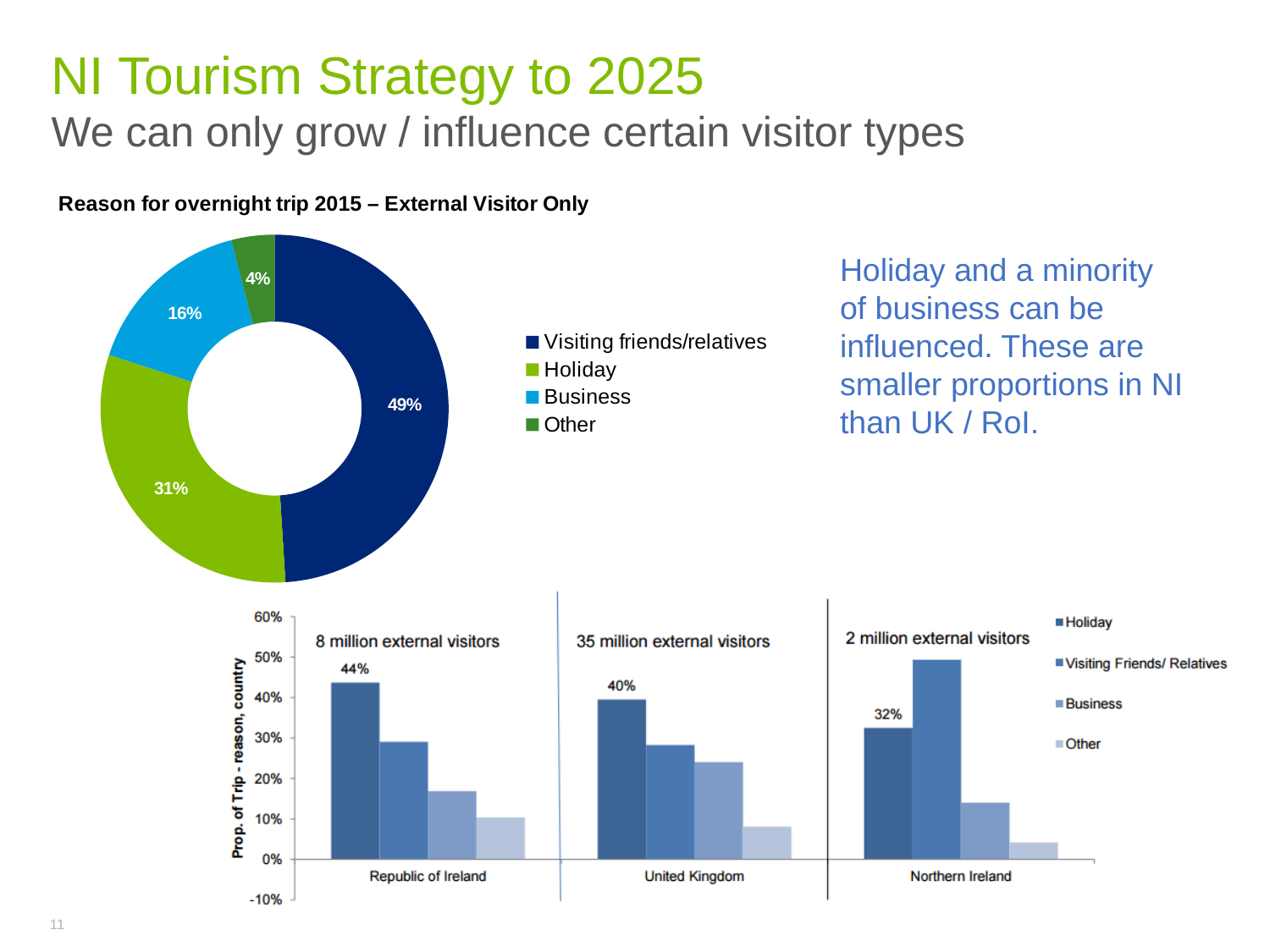
In the bar chart at the bottom of the slide, is the Visiting Friends/Relatives value for Northern Ireland greater or less than 40%? greater What type of chart is shown at the bottom of the slide? Bar chart How many categories does the legend of the donut chart 'Reason for overnight trip 2015 – External Visitor Only' list? 4 In the donut chart 'Reason for overnight trip 2015 – External Visitor Only', what is the difference in percentage points between Visiting friends/relatives and Holiday? 18 In the bar chart at the bottom of the slide, what is the Holiday value for Republic of Ireland? 44% In the bar chart at the bottom of the slide, which country has the lowest Holiday value? Northern Ireland In the bar chart at the bottom of the slide, is the Other value for Northern Ireland greater or less than 10%? less In the donut chart 'Reason for overnight trip 2015 – External Visitor Only', which reason has the smallest share? Other In the donut chart 'Reason for overnight trip 2015 – External Visitor Only', which is larger, Business or Other? Business In the donut chart 'Reason for overnight trip 2015 – External Visitor Only', what percentage is Holiday? 31% In the donut chart 'Reason for overnight trip 2015 – External Visitor Only', what percentage is Visiting friends/relatives? 49% In the bar chart at the bottom of the slide, what is the Holiday value for Northern Ireland? 32%